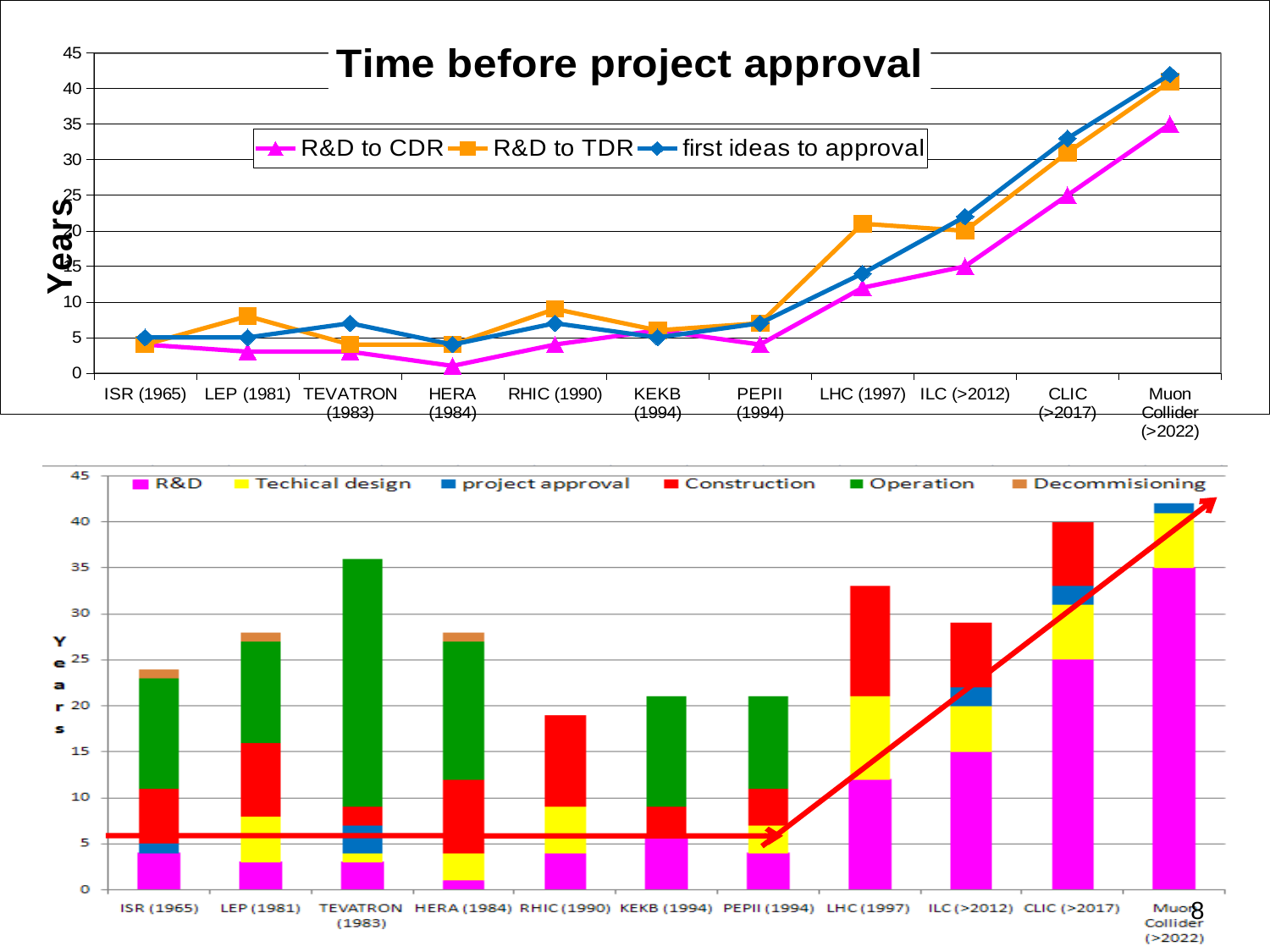
In the top chart 'Time before project approval', is the 'first ideas to approval' value for CLIC (>2017) greater or less than 30? greater In the bottom stacked bar chart, which is taller: the total bar for LHC (1997) or the total bar for ILC (>2012)? LHC (1997) In the top chart 'Time before project approval', which project has the highest value for 'first ideas to approval'? Muon Collider (>2022) How many projects are shown along the x axis of the top chart 'Time before project approval'? 11 How many series does the legend of the top chart 'Time before project approval' list? 3 How many series does the legend of the bottom stacked bar chart list? 6 What type of chart is the bottom chart on the slide? bar chart In the top chart 'Time before project approval', is the 'R&D to CDR' value for Muon Collider (>2022) greater or less than 30? greater In the bottom stacked bar chart, what colour represents the 'Construction' series? red In the top chart 'Time before project approval', which project has the lowest value for 'R&D to CDR'? HERA (1984) What type of chart is the top chart titled 'Time before project approval'? line chart In the bottom stacked bar chart, is the total bar for LHC (1997) greater or less than 30? greater